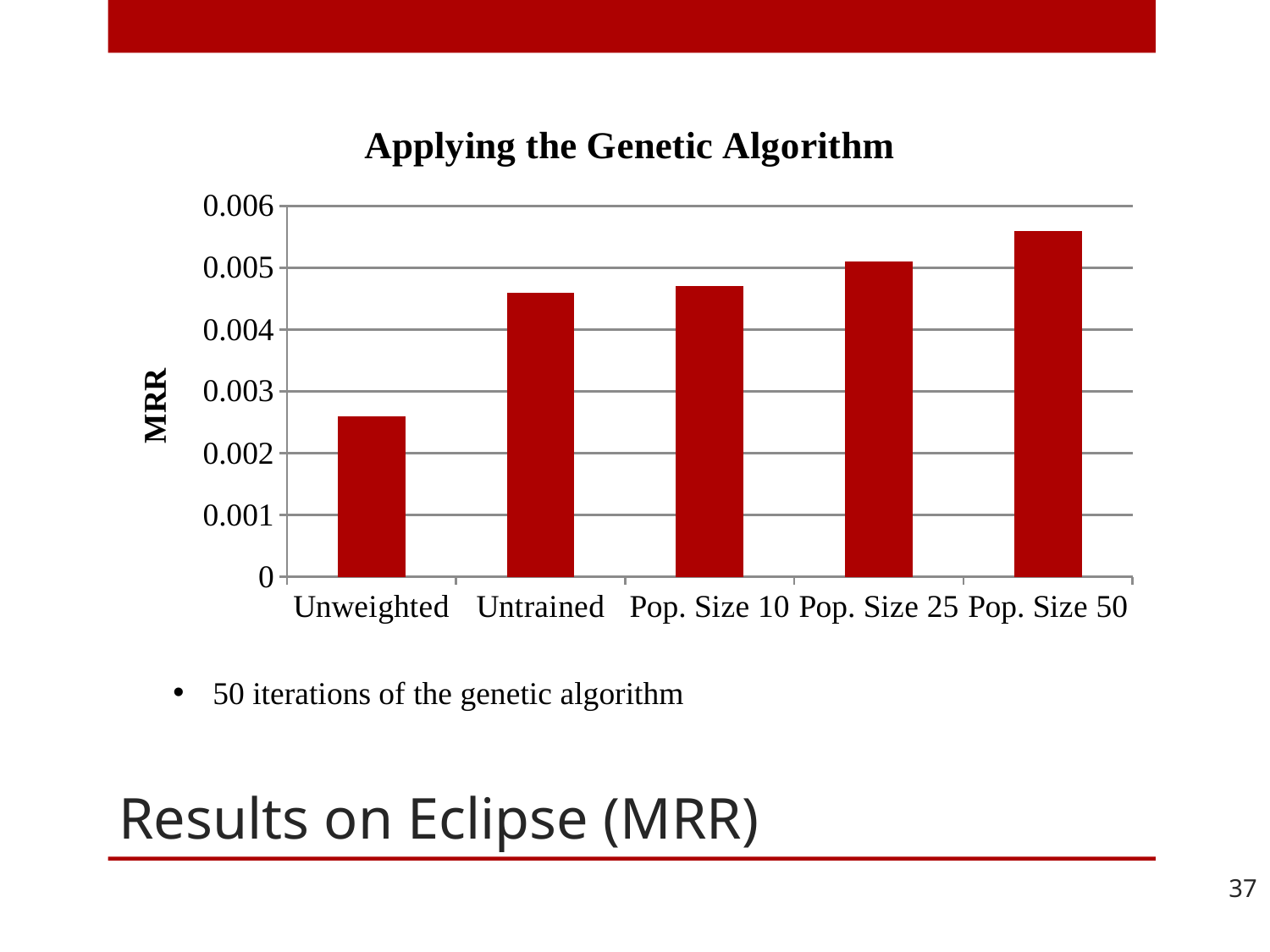
Is the MRR value for Pop. Size 50 greater or less than 0.005? greater Is the MRR value for Pop. Size 10 greater or less than 0.005? less What is the label on the vertical axis of the chart? MRR Which has a larger MRR value, Unweighted or Pop. Size 25? Pop. Size 25 Which category has the highest MRR value? Pop. Size 50 Is the MRR value for Untrained greater or less than 0.004? greater What kind of chart is shown on the slide? bar chart What is the title of the chart? Applying the Genetic Algorithm Do the MRR values rise or fall moving from left to right along the x axis? rise How many categories are shown on the x axis of the chart? 5 Which category has the lowest MRR value? Unweighted